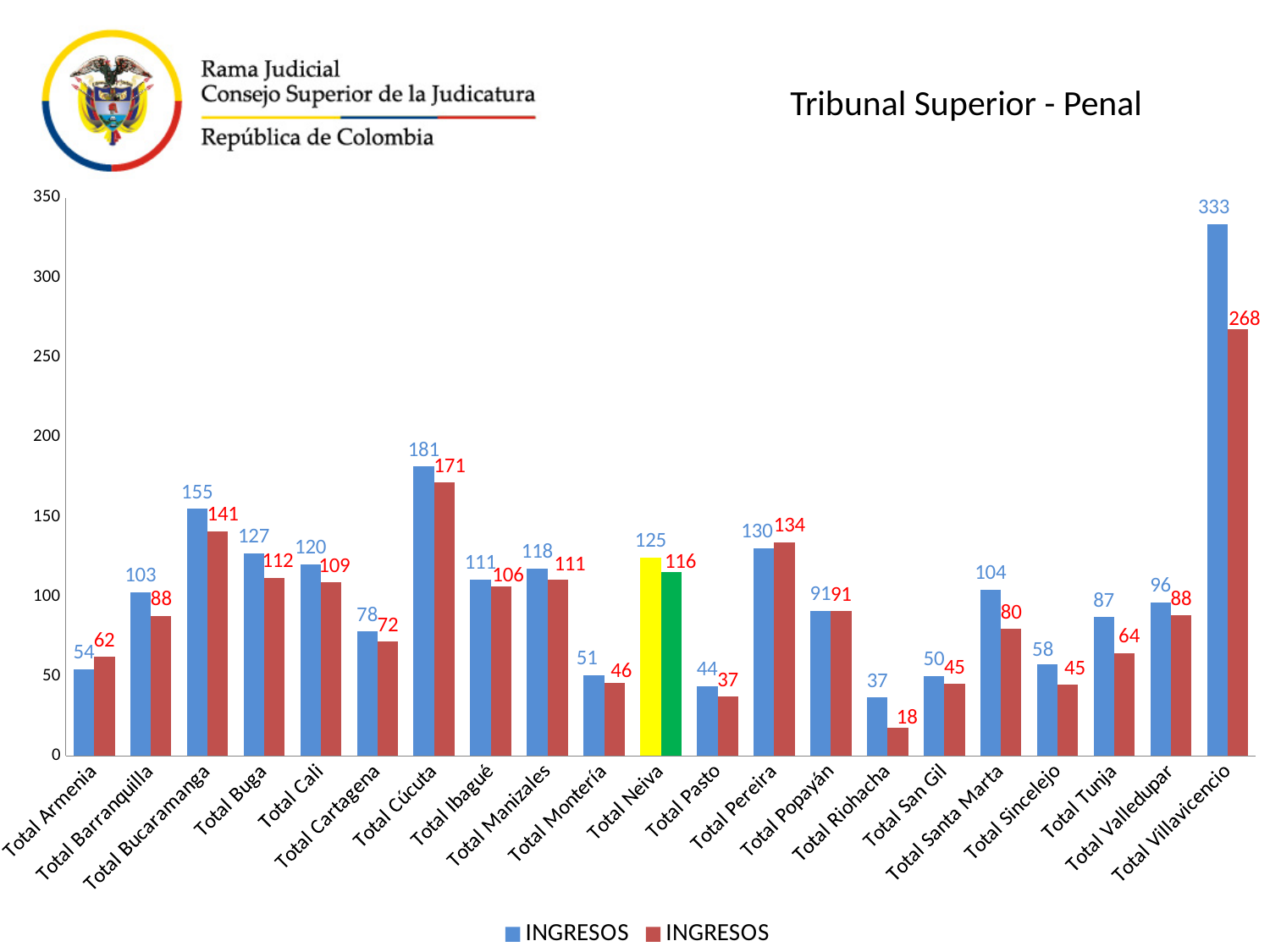
What is the difference between the blue and red bars for Total Villavicencio? 65 Which category has the highest blue bar? Total Villavicencio What is the value of the first (yellow) bar for Total Neiva? 125 What is the value of the blue bar for Total Cúcuta? 181 What is the difference between the blue and red bars for Total Cúcuta? 10 What kind of chart is shown on the slide? bar chart What is the value of the red bar for Total Villavicencio? 268 How many categories are shown on the x axis? 21 Which category has the lowest red bar? Total Riohacha For Total Armenia, which bar is larger, the blue one or the red one? the red one Is the value of the blue bar for Total Bucaramanga greater or less than 150? greater How many series does the legend list? 2